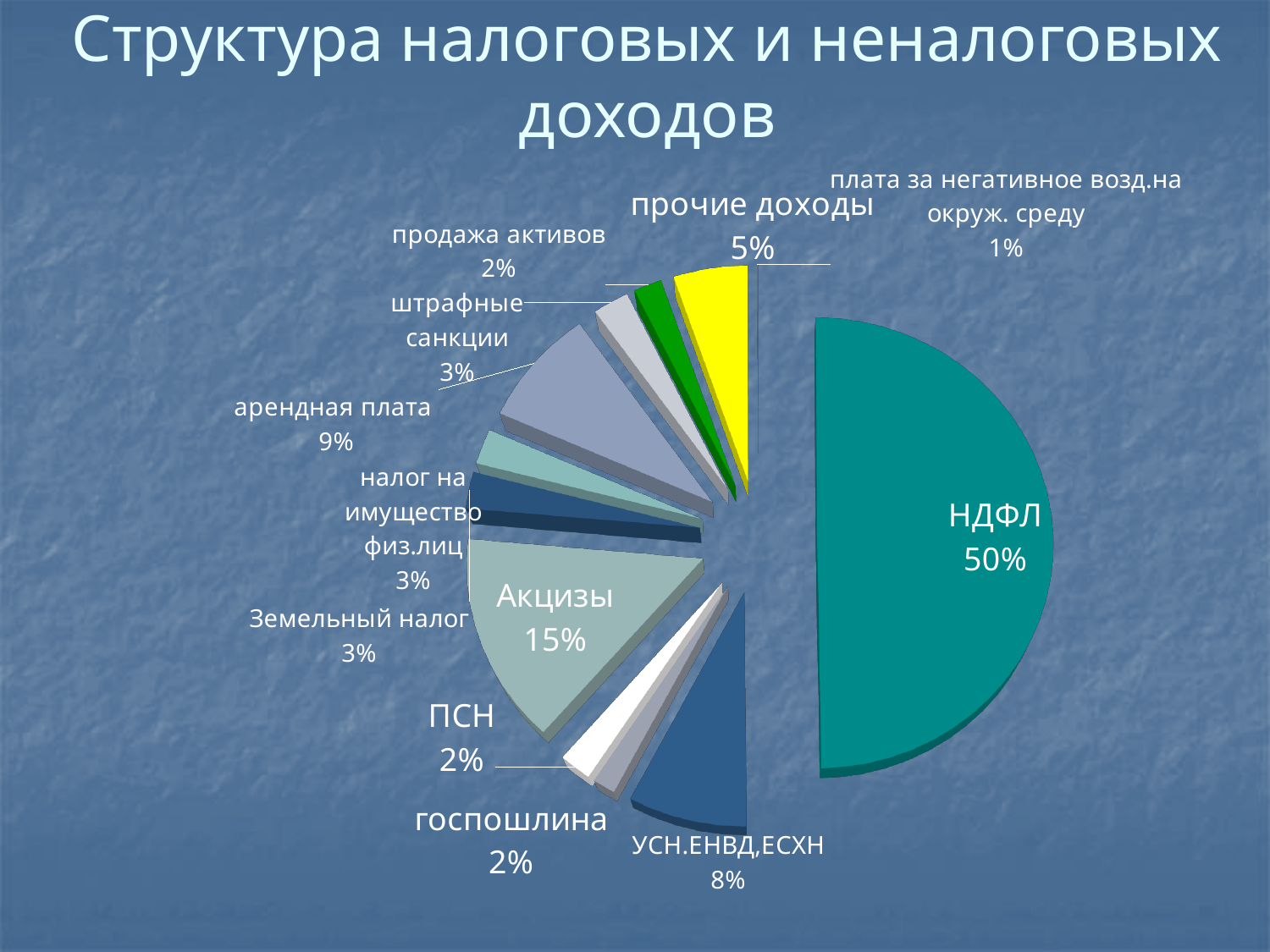
What is the value for УСН.ЕНВД,ЕСХН? 8% What is the difference between the shares of НДФЛ and Акцизы? 35% What kind of chart is shown on the slide? pie chart What is the title of the slide? Структура налоговых и неналоговых доходов What percentage is shown for арендная плата? 9% What share of the pie does НДФЛ have? 50% Which category has the smallest slice of the pie? плата за негативное возд.на окруж. среду Which category has the largest slice of the pie? НДФЛ How many slices does the pie chart have? 12 What is the value shown for Акцизы? 15% Which is larger, арендная плата or УСН.ЕНВД,ЕСХН? арендная плата What percentage is shown for плата за негативное возд.на окруж. среду? 1%